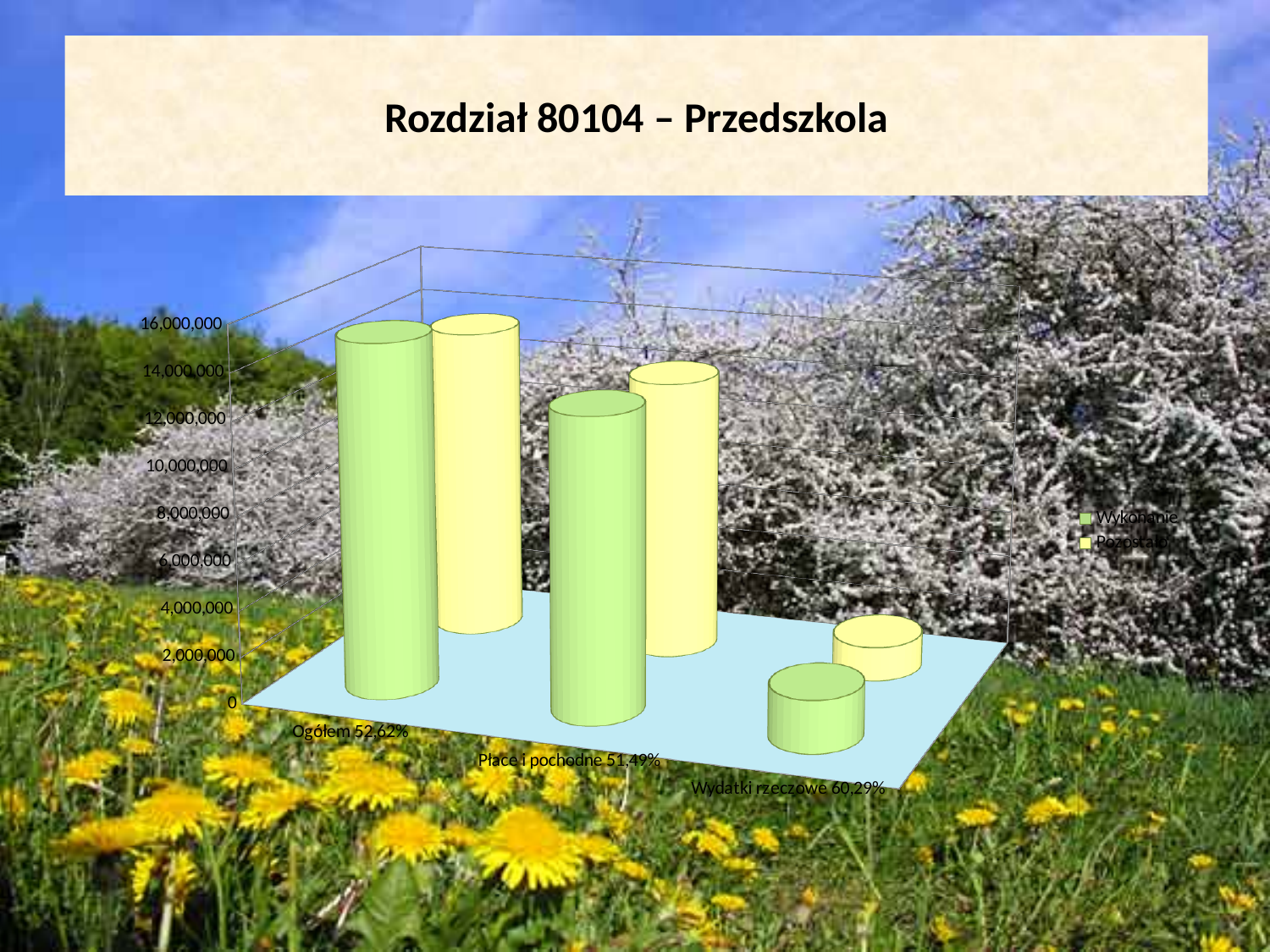
Is the Pozostało value for Płace i pochodne 51,49% greater or less than 6,000,000? greater How many categories are shown on the x axis of the chart? 3 How many series does the legend list? 2 What kind of chart is shown on the slide? bar chart Which is larger, the Wykonanie value for Ogółem 52,62% or for Wydatki rzeczowe 60,29%? Ogółem 52,62% What is the title of the slide containing the chart? Rozdział 80104 – Przedszkola Is the Wykonanie value for Wydatki rzeczowe 60,29% greater or less than 4,000,000? less Is the Wykonanie value for Ogółem 52,62% greater or less than 8,000,000? greater Which category has the highest Wykonanie value? Ogółem 52,62% Which series is shown in green in the chart? Wykonanie Which category has the lowest Wykonanie value? Wydatki rzeczowe 60,29% Which category has the lowest Pozostało value? Wydatki rzeczowe 60,29%